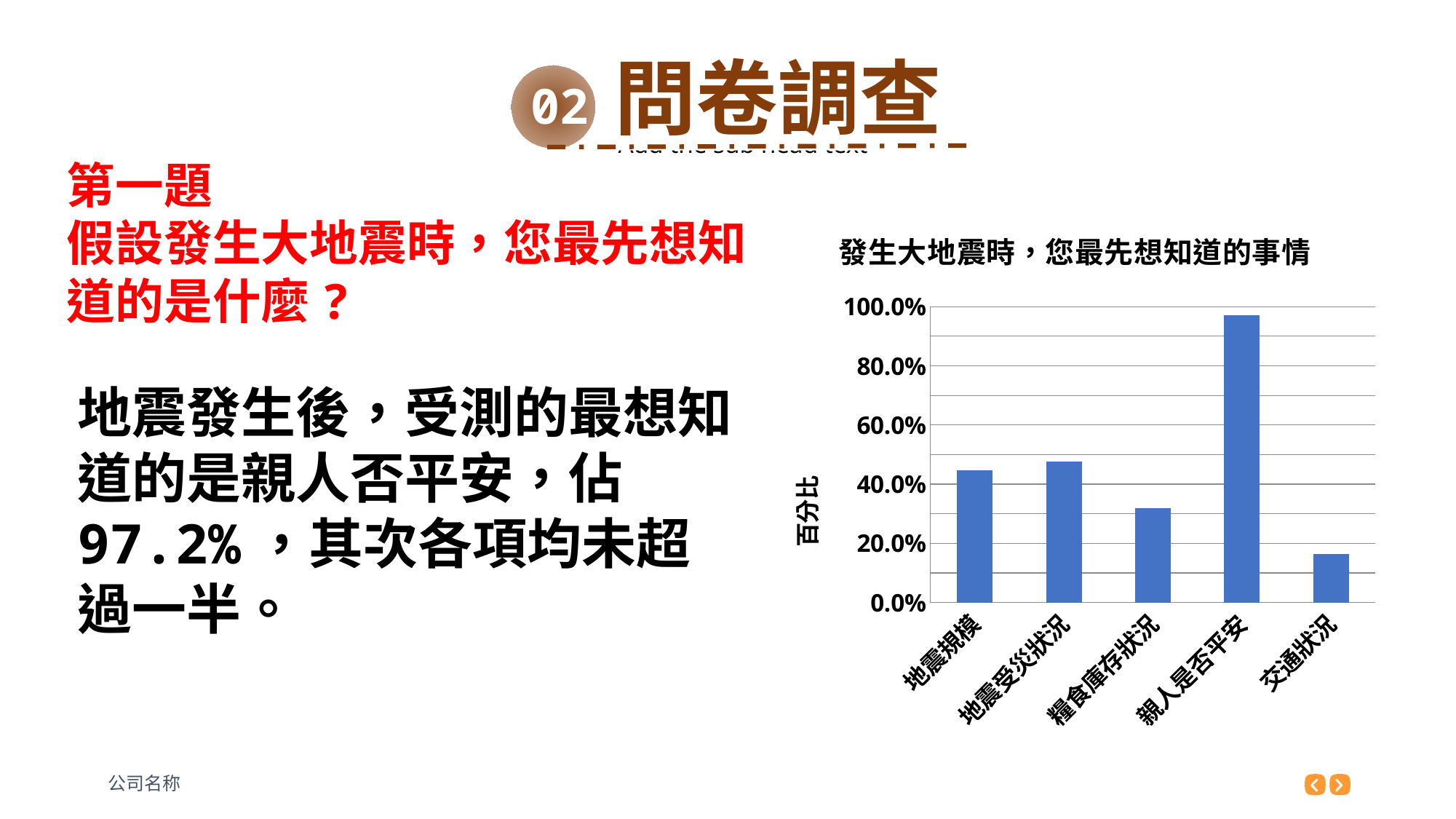
What kind of chart is shown on the slide? bar chart Is the value for 地震規模 greater or less than 40.0%? greater Which is larger, the value for 糧食庫存狀況 or the value for 交通狀況? 糧食庫存狀況 What is the title of the chart? 發生大地震時，您最先想知道的事情 How many categories are shown on the x axis of the chart? 5 Is the value for 親人是否平安 greater or less than 80.0%? greater Which category has the highest value in the chart? 親人是否平安 Is the value for 糧食庫存狀況 greater or less than 40.0%? less What is the label on the vertical axis of the chart? 百分比 Which category has the lowest value in the chart? 交通狀況